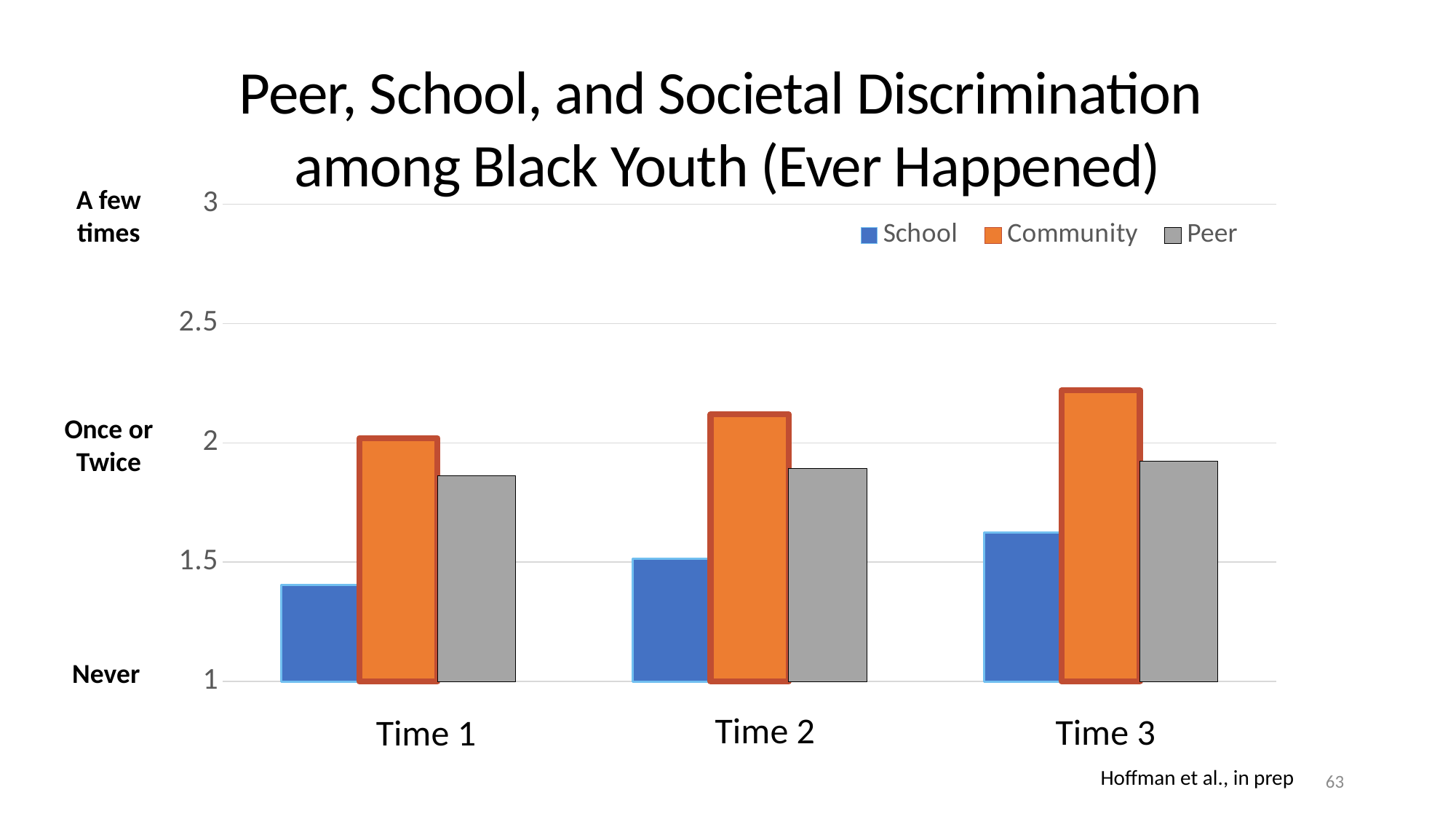
What colour are the Community bars? orange Is the value for Peer at Time 1 greater or less than 2? less How many time points are shown on the x axis? 3 Is the value for School at Time 1 greater or less than 1.5? less Do the School values rise or fall from Time 1 to Time 3? rise Which is larger at Time 2, the School value or the Peer value? Peer Which series has the lowest bar at Time 1? School What kind of chart is shown on the slide? bar chart Is the value for School at Time 3 greater or less than 1.5? greater Which series has the highest bar at Time 3? Community How many series does the legend list? 3